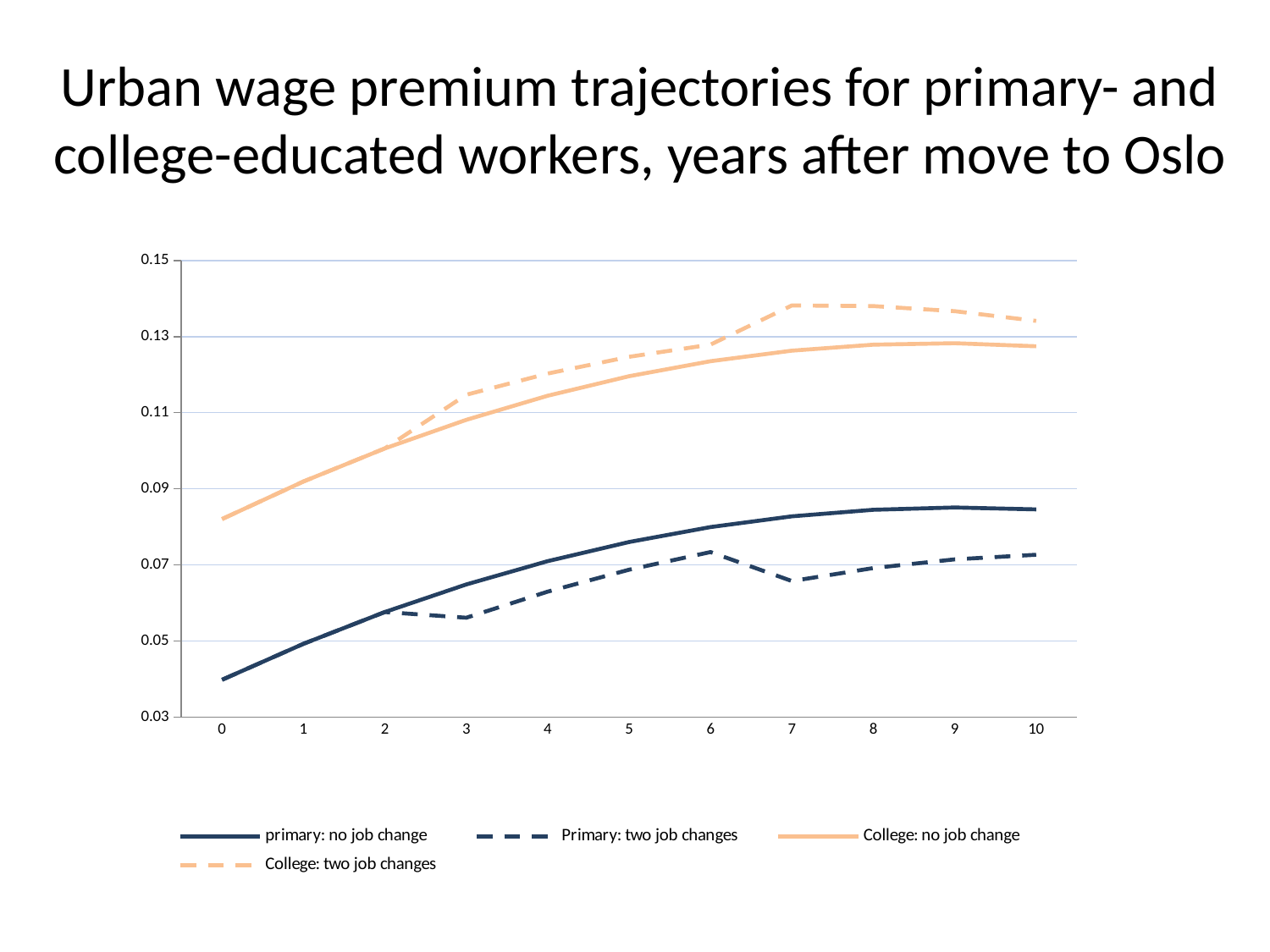
What kind of chart is shown on the slide? line chart How many series does the legend list? 4 At year 7, which is higher: 'College: two job changes' or 'College: no job change'? College: two job changes Which series has the lowest value at year 10? Primary: two job changes Is the value for 'College: no job change' at year 0 greater or less than 0.09? less Does the 'primary: no job change' line rise or fall from year 0 to year 10? rise Is the value for 'Primary: two job changes' at year 7 greater or less than 0.07? less At year 3, which is higher: 'primary: no job change' or 'Primary: two job changes'? primary: no job change How many year values are marked along the x axis? 11 Is the value for 'College: two job changes' at year 7 greater or less than 0.13? greater Which series has the highest value at year 10? College: two job changes